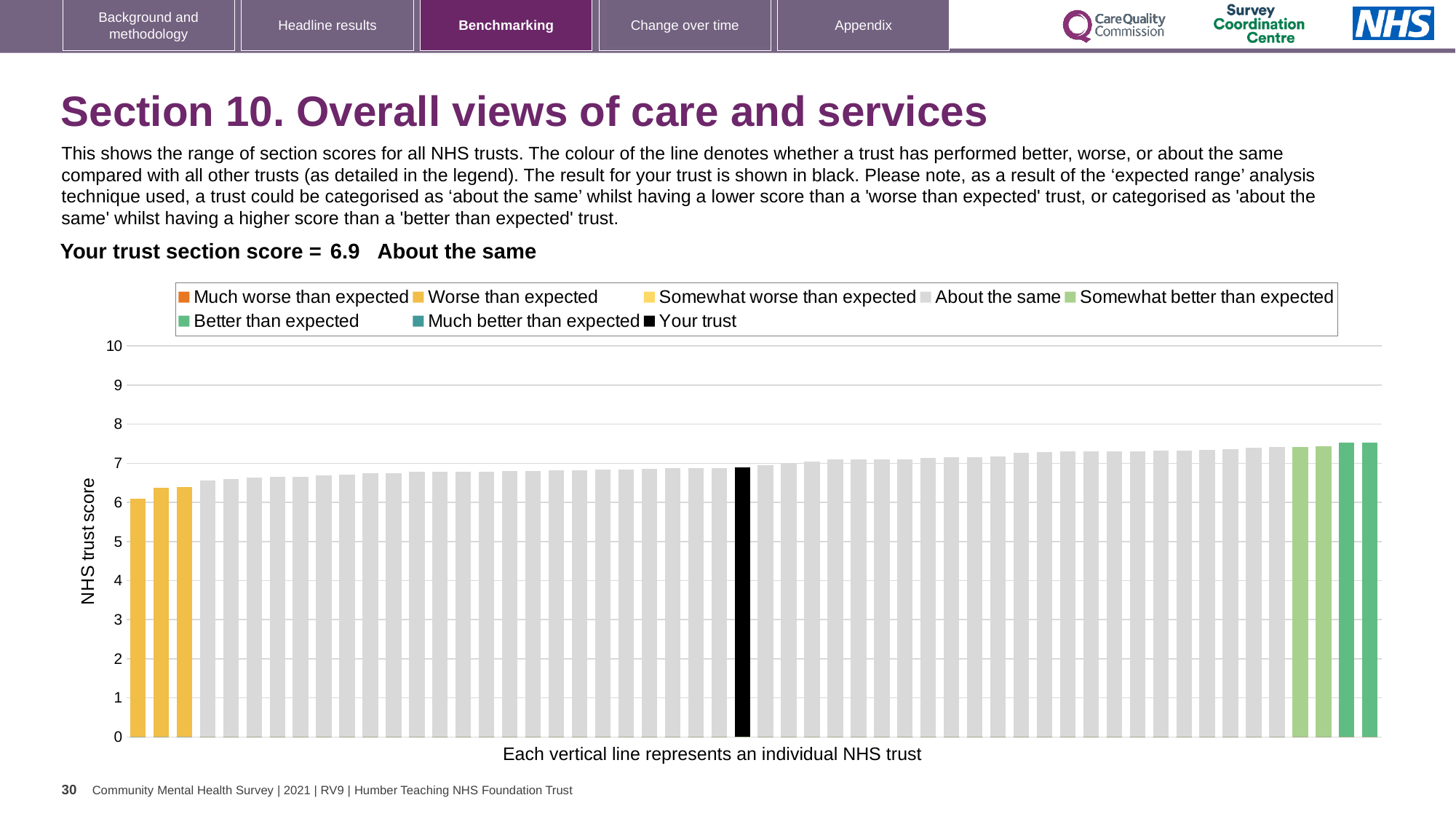
Is the value of the black 'Your trust' bar greater or less than 5? greater What kind of chart is shown on the slide? bar chart Is the value of the highest bar in the chart greater or less than 7? greater Is the value of the lowest bar in the chart greater or less than 7? less How is the trust's section score of 6.9 categorised on the slide? About the same What is the trust's section score shown on the slide? 6.9 Which is larger: the black 'Your trust' bar or the leftmost bar in the chart? Your trust What is the label on the y axis of the chart? NHS trust score What colour is the bar representing 'Your trust' in the chart? black Do the bar values rise or fall from left to right along the x axis? rise How many bars are coloured as 'Worse than expected' in the chart? 3 How many entries does the chart legend list? 8